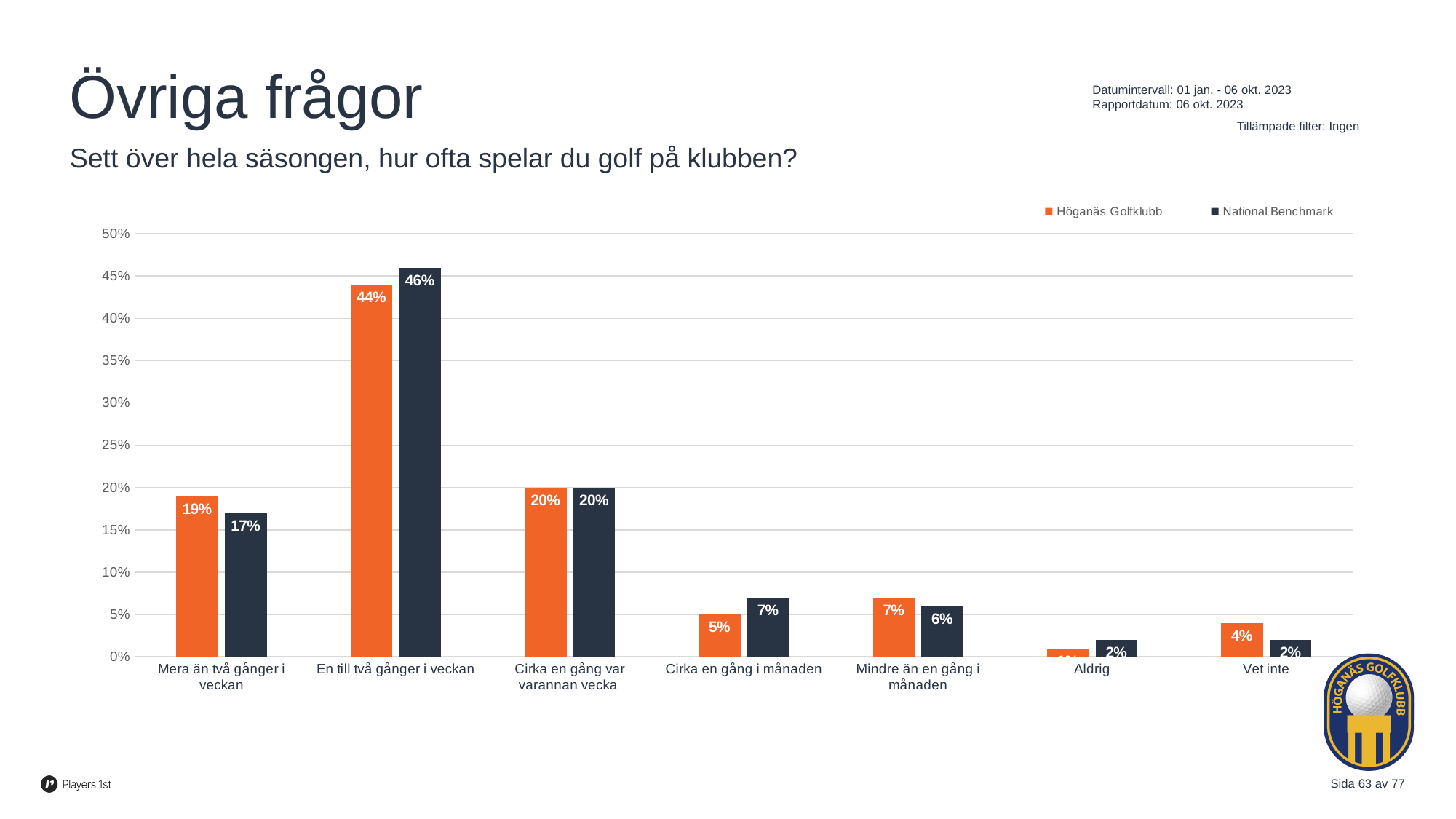
What is the Höganäs Golfklubb value for 'En till två gånger i veckan'? 44% Which category has the lowest Höganäs Golfklubb value? Aldrig What is the National Benchmark value for 'Mera än två gånger i veckan'? 17% How many series does the legend list? 2 How many categories are shown on the x axis? 7 Is the Höganäs Golfklubb value for 'Cirka en gång var varannan vecka' greater or less than 15%? greater What is the difference between the National Benchmark and Höganäs Golfklubb values for 'En till två gånger i veckan'? 2% Which category has the highest National Benchmark value? En till två gånger i veckan What kind of chart is shown on the slide? bar chart What is the Höganäs Golfklubb value for 'Vet inte'? 4% Which series is shown in orange in the legend? Höganäs Golfklubb For 'Cirka en gång i månaden', which series has the larger value, Höganäs Golfklubb or National Benchmark? National Benchmark